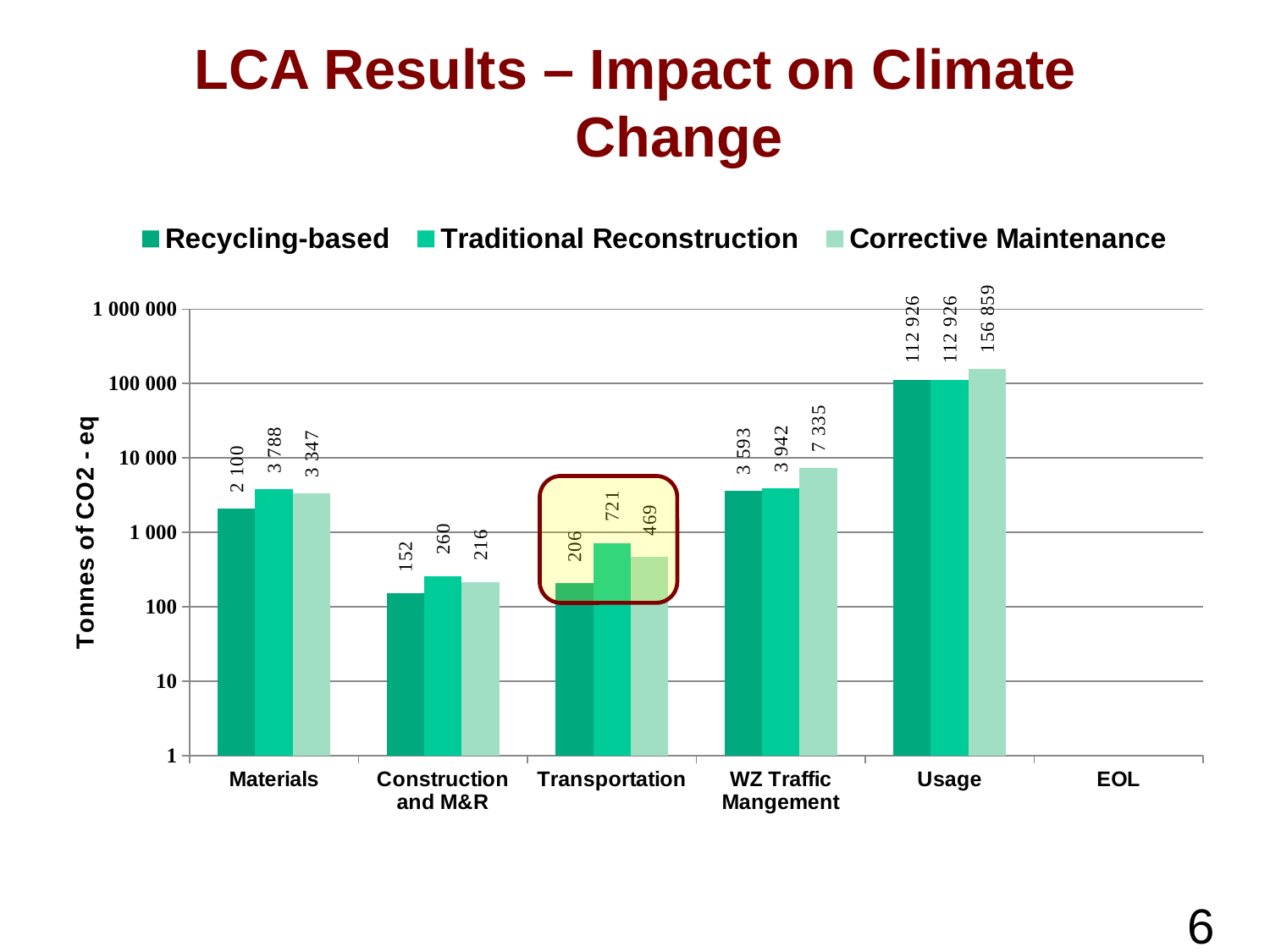
Which is larger in the Materials category, Recycling-based or Corrective Maintenance? Corrective Maintenance What is the value for Traditional Reconstruction in the Materials category? 3 788 What is the value for Corrective Maintenance in the WZ Traffic Mangement category? 7 335 What is the label of the vertical axis? Tonnes of CO2 - eq What is the difference between Corrective Maintenance and Recycling-based in the Usage category? 43 933 Which category has the highest value for Recycling-based? Usage What is the value for Corrective Maintenance in the Usage category? 156 859 How many series does the legend list? 3 What kind of chart is shown on the slide? Bar chart What is the value for Recycling-based in the Transportation category? 206 What is the difference between Traditional Reconstruction and Recycling-based in the Transportation category? 515